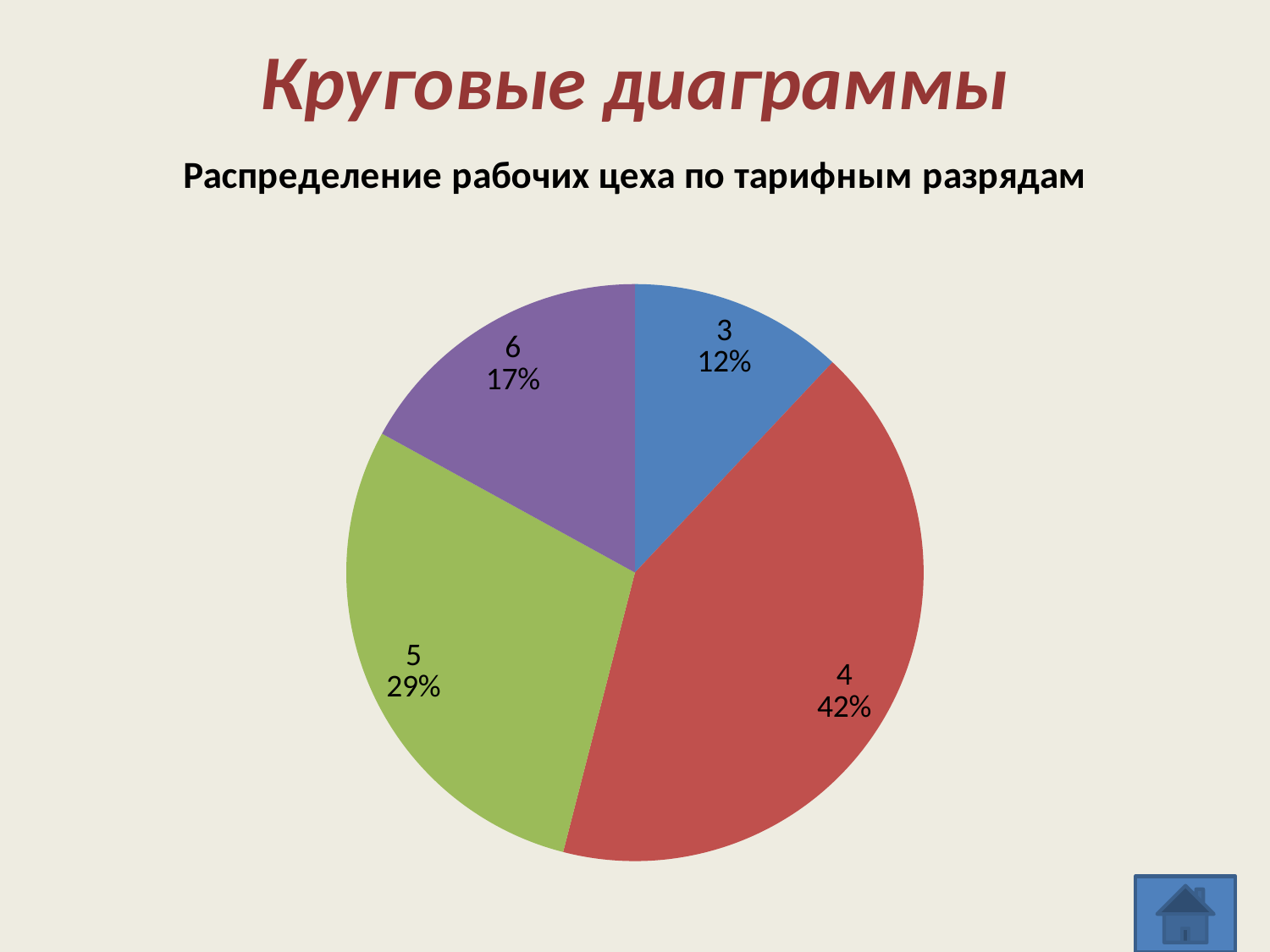
What share of the pie does tariff grade 3 have? 12% Which tariff grade has the largest share of workers? 4 What type of chart is shown on the slide? pie chart What is the difference in percentage points between the shares of grade 6 and grade 3? 5% How many slices does the pie chart have? 4 Which has a larger share, grade 6 or grade 3? 6 What share of the pie does tariff grade 4 have? 42% What share of the pie does tariff grade 5 have? 29% What is the difference in percentage points between the shares of grade 4 and grade 5? 13% Which tariff grade has the smallest share of workers? 3 What is the title of the chart? Распределение рабочих цеха по тарифным разрядам